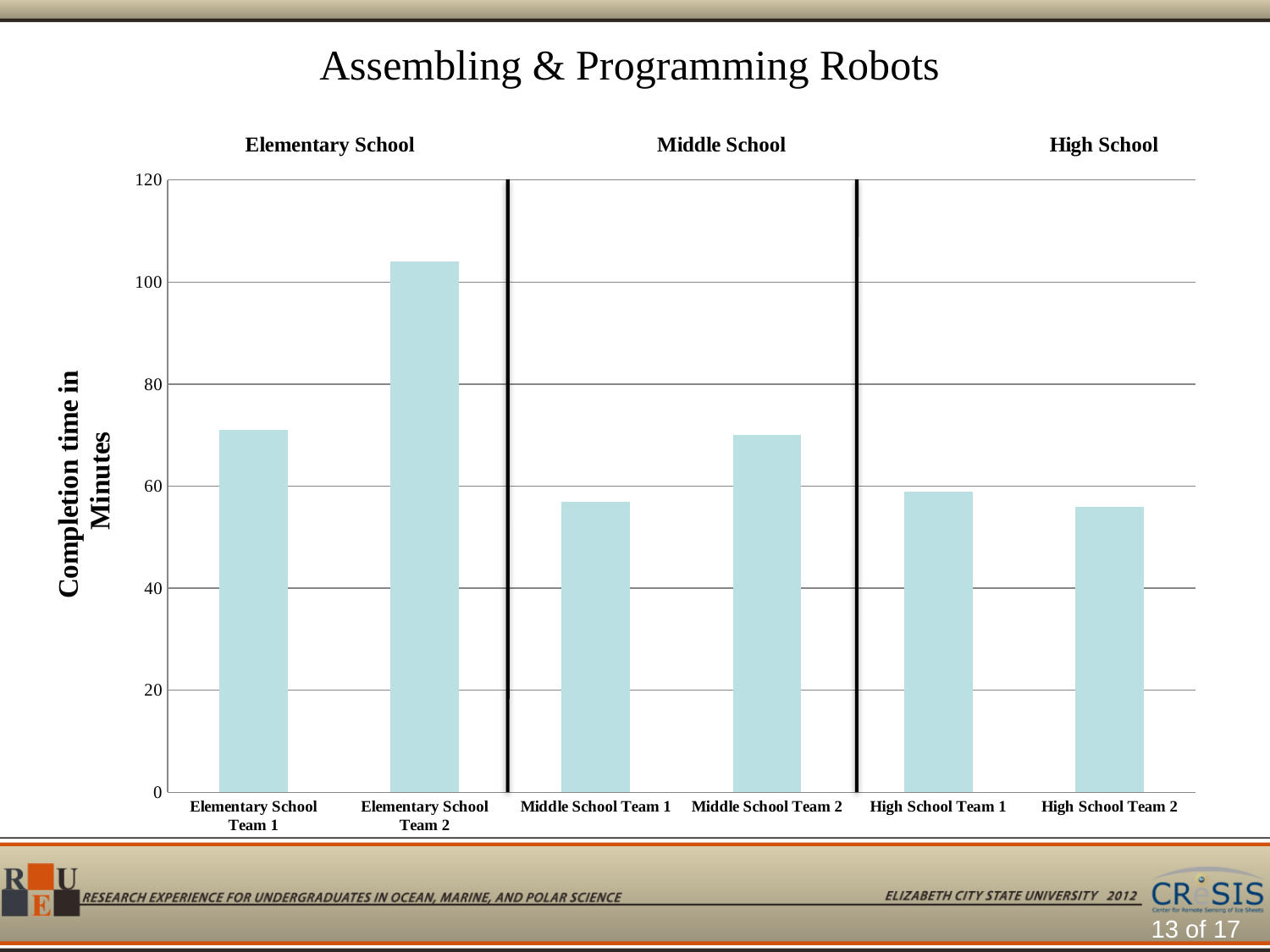
How many teams (bars) are plotted in the chart? 6 Is the completion time for High School Team 2 greater or less than 60 minutes? less Is the completion time for Middle School Team 2 greater or less than 60 minutes? greater Is the completion time for Elementary School Team 1 greater or less than 60 minutes? greater Which has the larger completion time, Elementary School Team 2 or High School Team 1? Elementary School Team 2 Which team has the highest completion time? Elementary School Team 2 What type of chart is shown on the slide? bar chart What is the label on the vertical axis of the chart? Completion time in Minutes Which has the larger completion time, Middle School Team 1 or Middle School Team 2? Middle School Team 2 What is the title of the chart? Assembling & Programming Robots